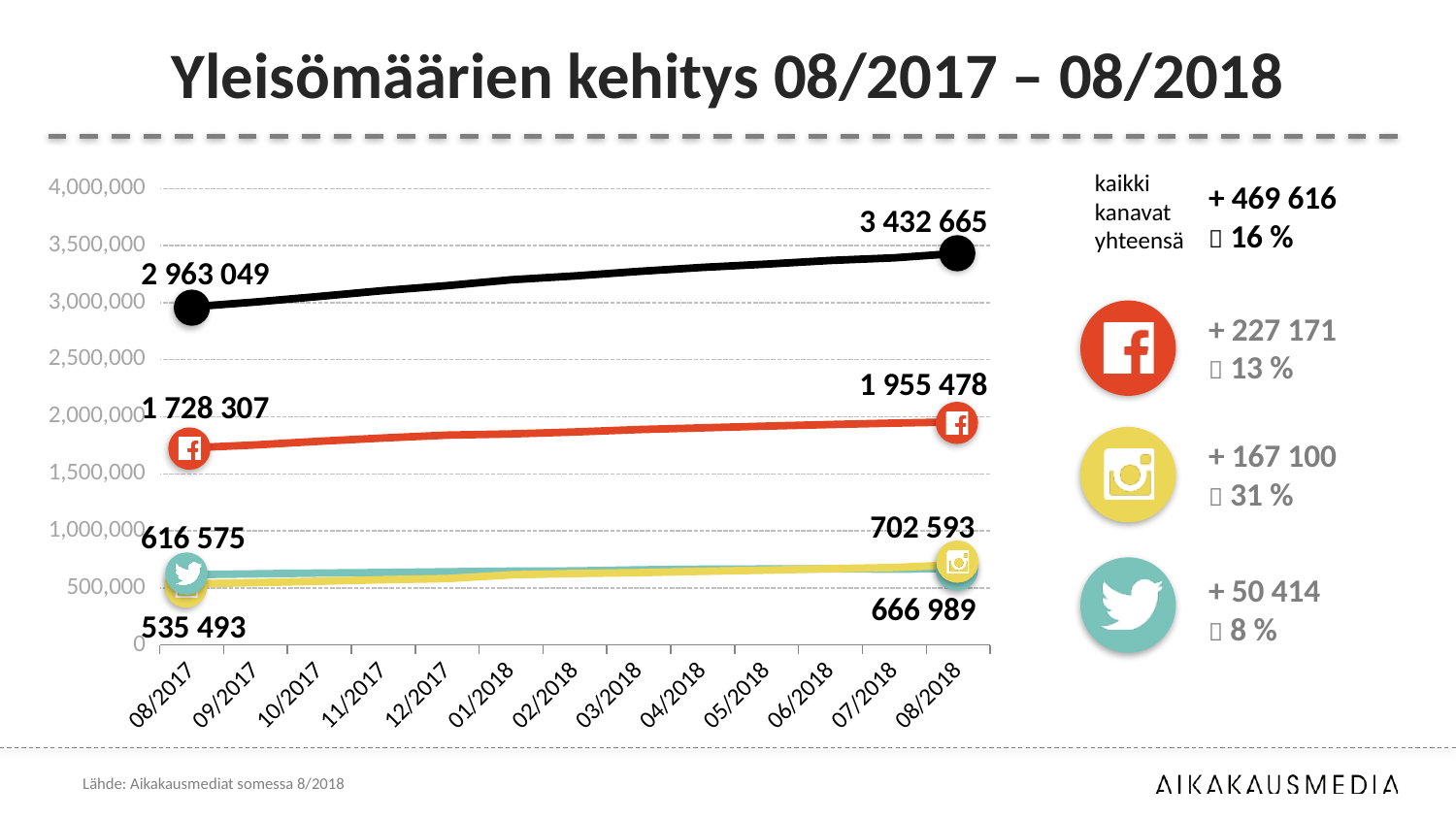
By how much did the total (black line) grow from 08/2017 to 08/2018? 469 616 Which is larger at 08/2018, the Instagram value or the Twitter value? Instagram What is the Twitter value at 08/2017? 616 575 What is the Facebook value at 08/2018? 1 955 478 What is the value of the black (total) line at 08/2017? 2 963 049 How many months are shown on the x axis? 13 What is the value of the black (total) line at 08/2018? 3 432 665 What type of chart is shown on the slide? line chart Does the black (total) line rise or fall from 08/2017 to 08/2018? rise What is the Instagram value at 08/2018? 702 593 By how much did the Facebook value grow from 08/2017 to 08/2018? 227 171 What is the Facebook value at 08/2017? 1 728 307